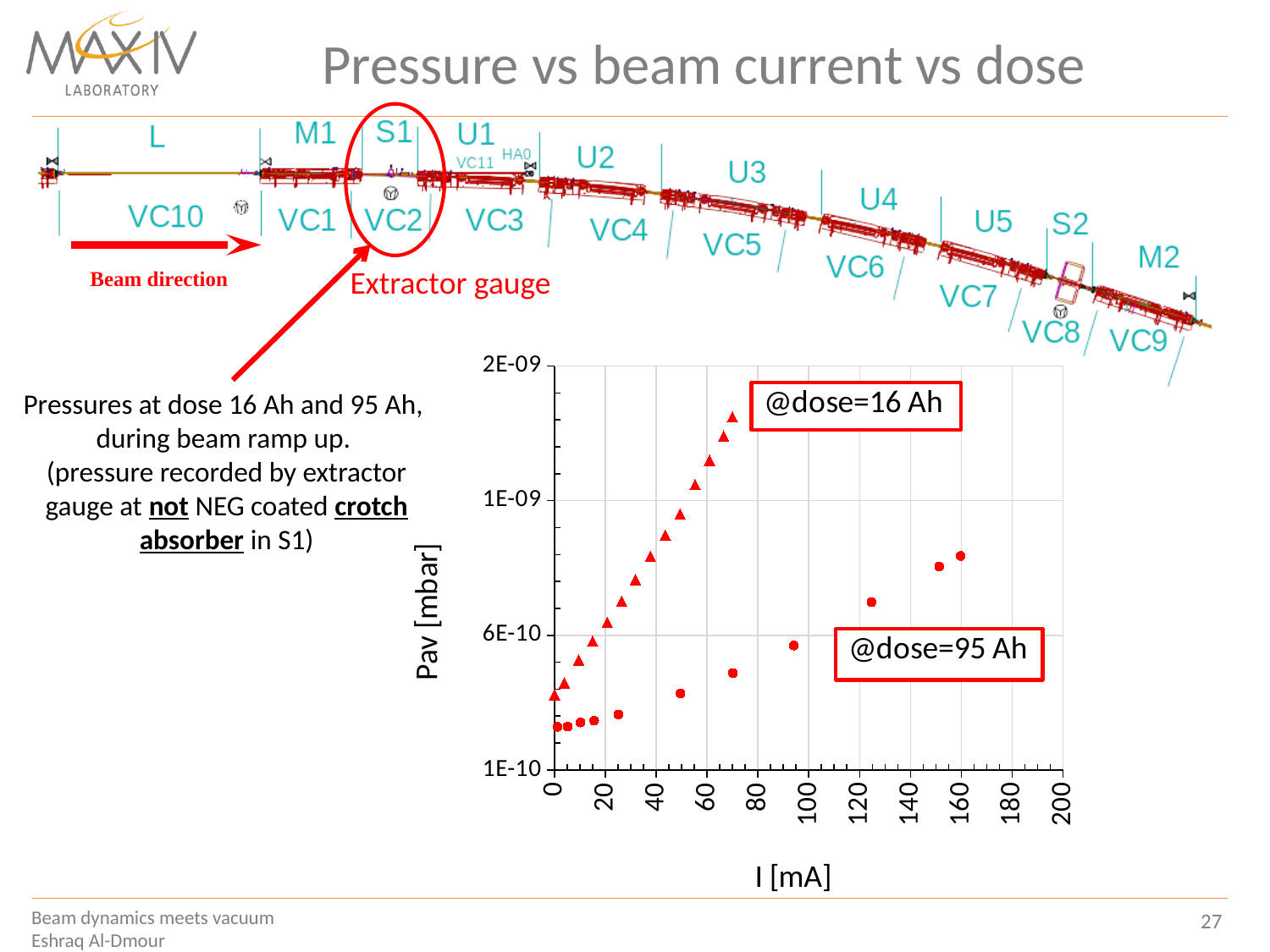
Is the pressure for the @dose=16 Ah series at 70 mA greater or less than 1E-09 mbar? greater What is the label of the y axis of the chart? Pav [mbar] What is the maximum value shown on the x axis of the chart? 200 Is the pressure for the @dose=95 Ah series at 160 mA greater or less than 1E-09 mbar? less What kind of chart is shown on the slide? scatter chart What is the label of the x axis of the chart? I [mA] Does the pressure for the @dose=95 Ah series rise or fall as beam current increases? rise How many data series are plotted in the chart? 2 Which series reaches higher pressure values at the same beam current, @dose=16 Ah or @dose=95 Ah? @dose=16 Ah Is the pressure for the @dose=16 Ah series at 40 mA greater or less than 6E-10 mbar? greater Does the pressure for the @dose=16 Ah series rise or fall as beam current increases? rise